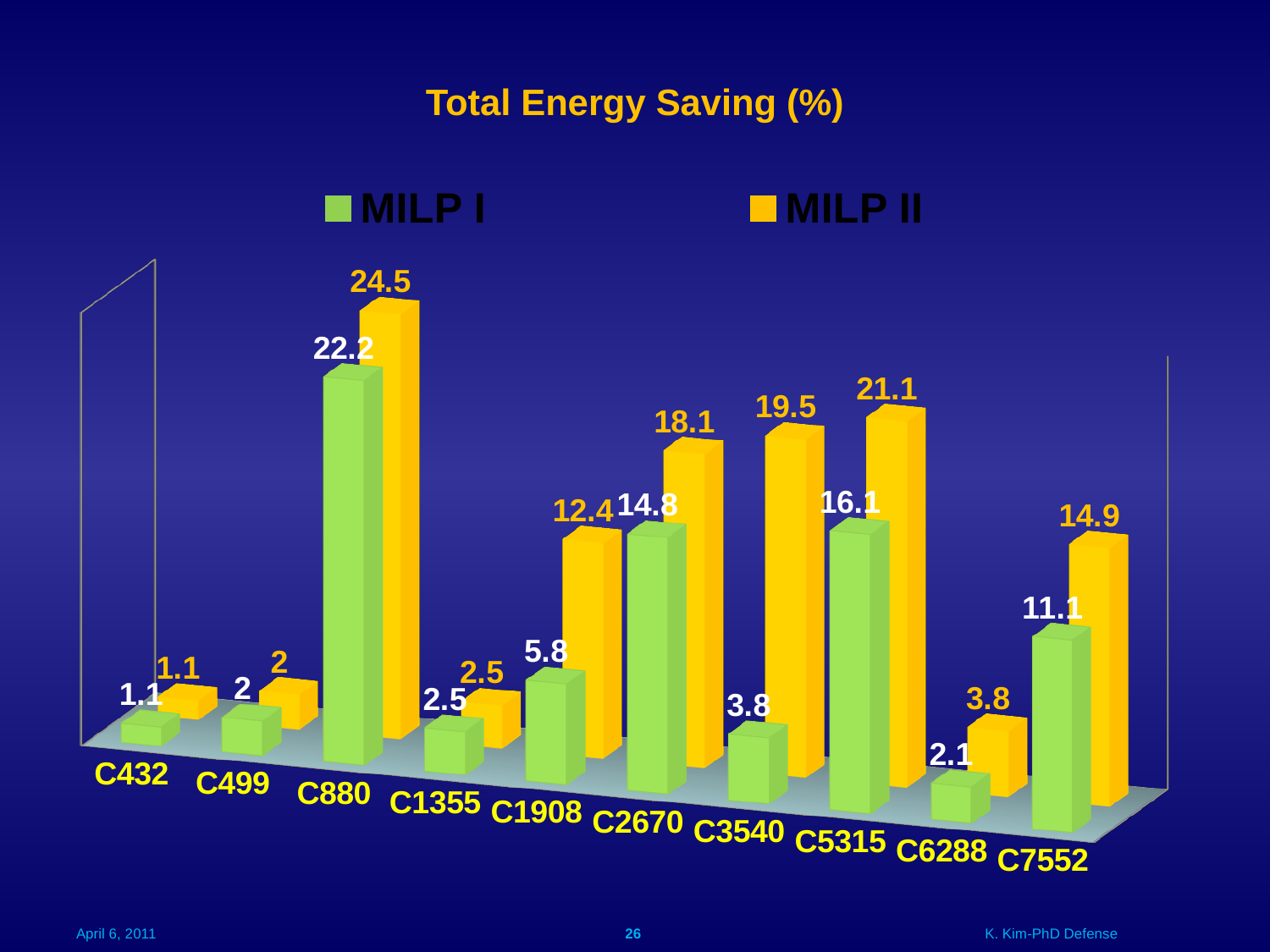
Which is larger for C2670, the MILP I value or the MILP II value? MILP II Which category has the highest MILP I value? C880 What is the MILP II value for C880? 24.5 How many series does the legend list? 2 What is the title of the chart? Total Energy Saving (%) How many categories are shown on the x axis? 10 What is the difference between the MILP II and MILP I values for C3540? 15.7 What is the MILP I value for C7552? 11.1 What kind of chart is shown on the slide? Bar chart Which category has the lowest MILP II value? C432 What is the MILP I value for C5315? 16.1 What is the MILP II value for C3540? 19.5